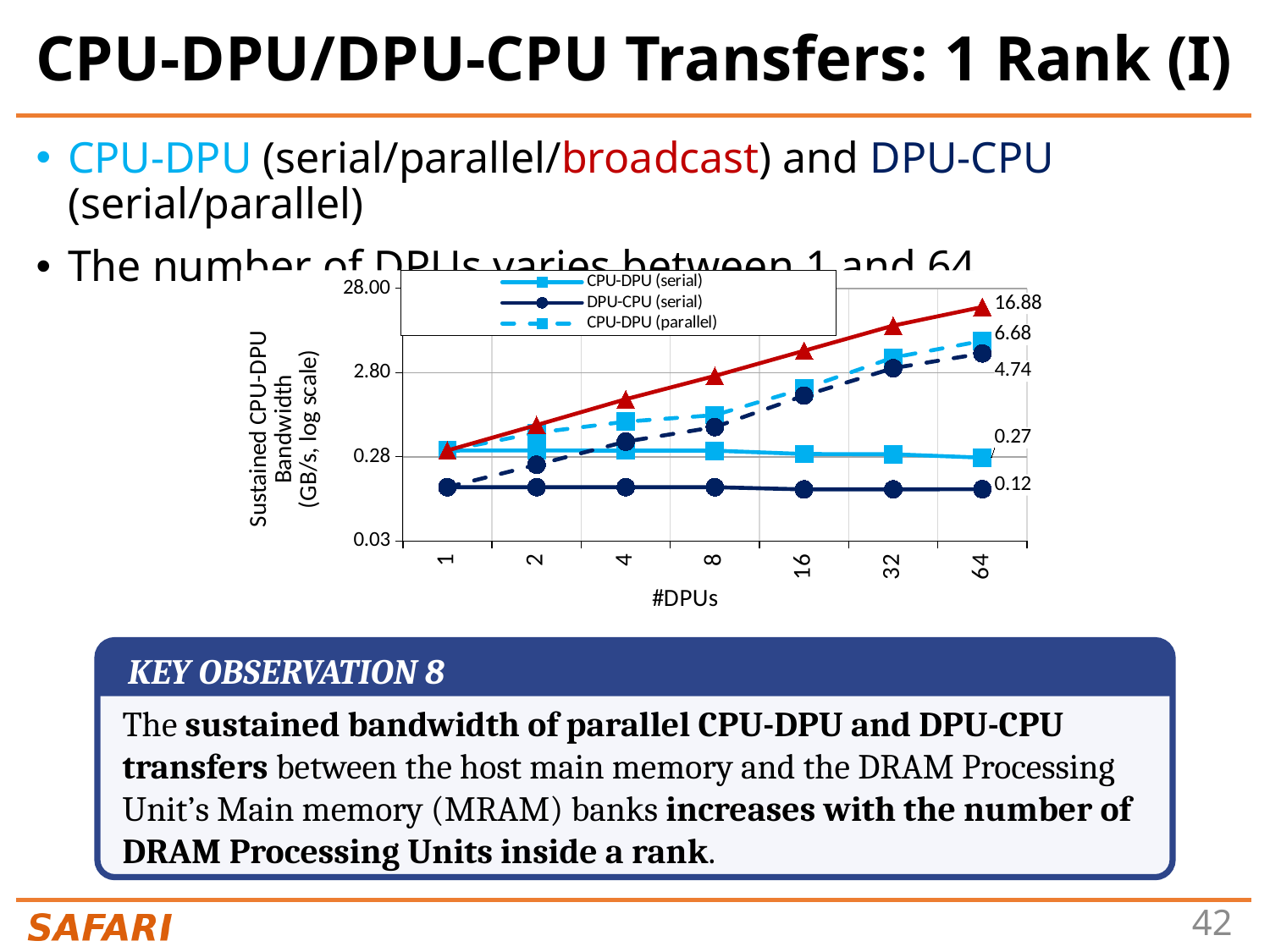
Does the CPU-DPU (parallel) line rise or fall as the number of DPUs increases? rises What kind of chart is shown on the slide? line chart What is the sustained bandwidth for CPU-DPU (parallel) at 64 DPUs? 6.68 Is the value for CPU-DPU (parallel) at 16 DPUs greater or less than 0.28? greater What is the label of the x axis of the chart? #DPUs At 64 DPUs, what is the difference between the CPU-DPU (serial) value and the DPU-CPU (serial) value? 0.15 What is the sustained bandwidth for DPU-CPU (serial) at 64 DPUs? 0.12 At 64 DPUs, what is the difference between the CPU-DPU (parallel) value and the CPU-DPU (serial) value? 6.41 How many #DPUs values are shown on the x axis of the chart? 7 What is the sustained bandwidth for CPU-DPU (serial) at 64 DPUs? 0.27 Is the value for DPU-CPU (serial) at 1 DPU greater or less than 0.28? less At 64 DPUs, which is larger: CPU-DPU (serial) or DPU-CPU (serial)? CPU-DPU (serial)